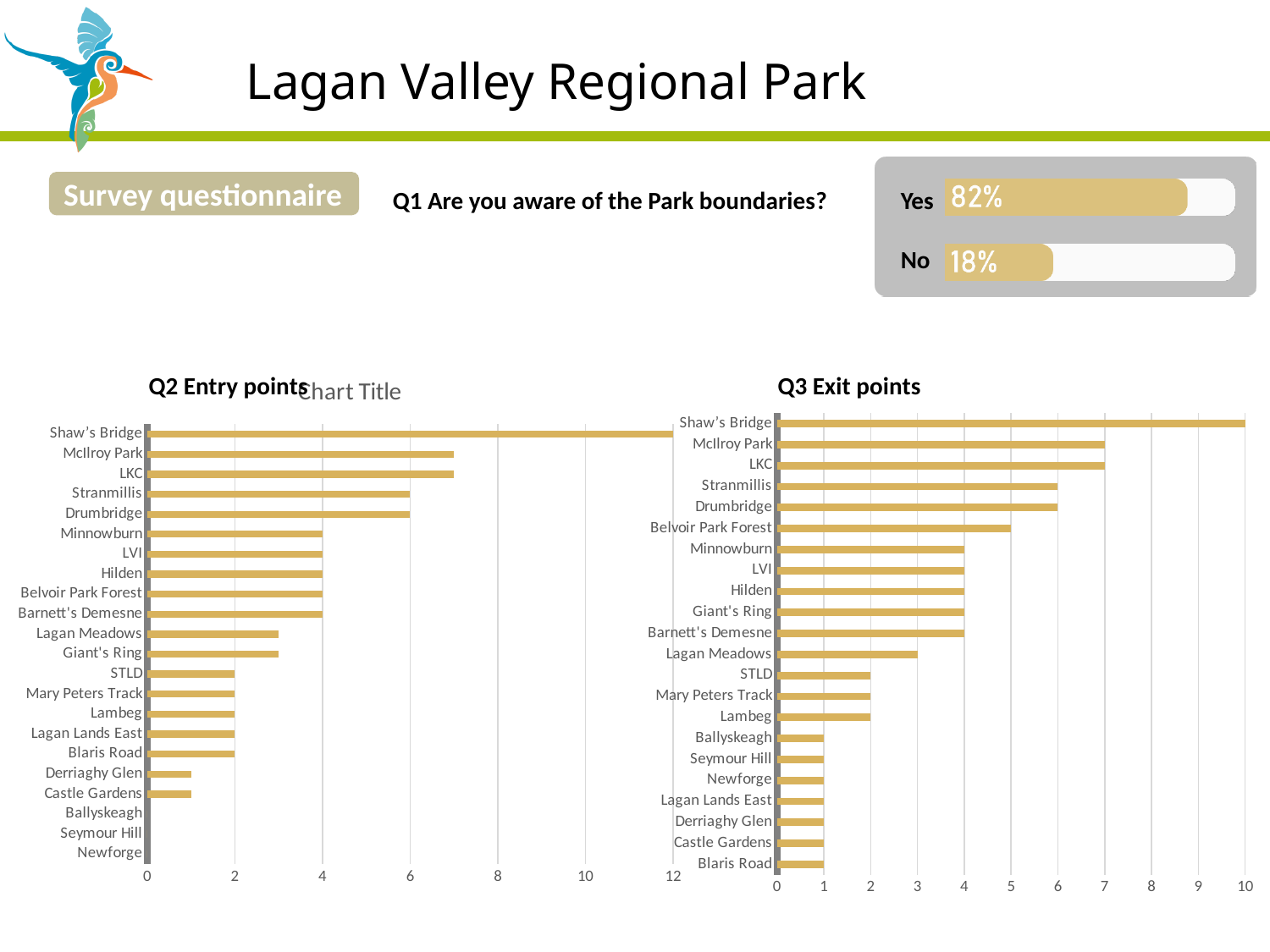
In the Q3 Exit points chart, what is the value for Shaw's Bridge? 10 In the Q3 Exit points chart, what is the value for Belvoir Park Forest? 5 How many exit points are listed in the Q3 Exit points chart? 22 In the Q2 Entry points chart, what is the value for Stranmillis? 6 What placeholder title text appears above the Q2 Entry points chart's plot area? Chart Title In the Q2 Entry points chart, which entry point has the highest value? Shaw's Bridge In the Q3 Exit points chart, which has the larger value, Stranmillis or Lagan Meadows? Stranmillis How many entry points are listed in the Q2 Entry points chart? 22 What kind of chart is the Q2 Entry points chart? bar chart In the Q3 Exit points chart, what is the difference between the values for Shaw's Bridge and McIlroy Park? 3 In the Q2 Entry points chart, is the value for McIlroy Park greater or less than 6? greater